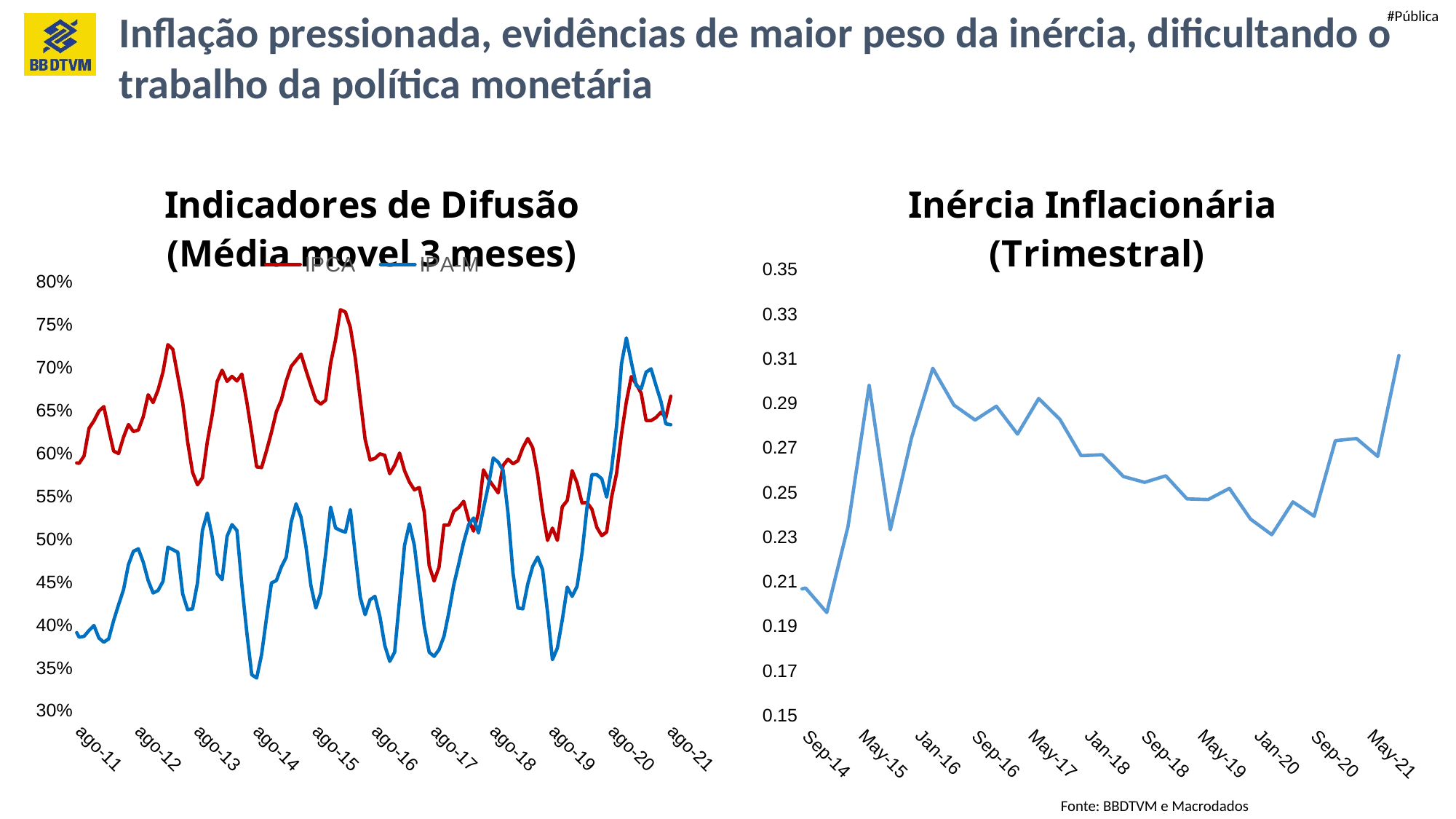
In the 'Indicadores de Difusão' chart, what colour is the IPCA line? red In the 'Indicadores de Difusão' chart, is the IPCA value at ago-11 greater or less than 55%? greater Which two series are listed in the legend of the 'Indicadores de Difusão' chart? IPCA and IPA-M In the 'Indicadores de Difusão' chart, is the lowest IPA-M value (around ago-14) greater or less than 35%? less What kind of chart is the 'Inércia Inflacionária (Trimestral)' chart? line chart In the 'Inércia Inflacionária (Trimestral)' chart, is the last value (around May-21) greater or less than 0.29? greater What kind of chart is the 'Indicadores de Difusão (Média movel 3 meses)' chart? line chart How many series does the legend of the 'Indicadores de Difusão' chart list? 2 In the 'Indicadores de Difusão' chart, which series is higher at ago-11, IPCA or IPA-M? IPCA In the 'Inércia Inflacionária (Trimestral)' chart, does the line rise or fall between Jan-20 and May-21? rise